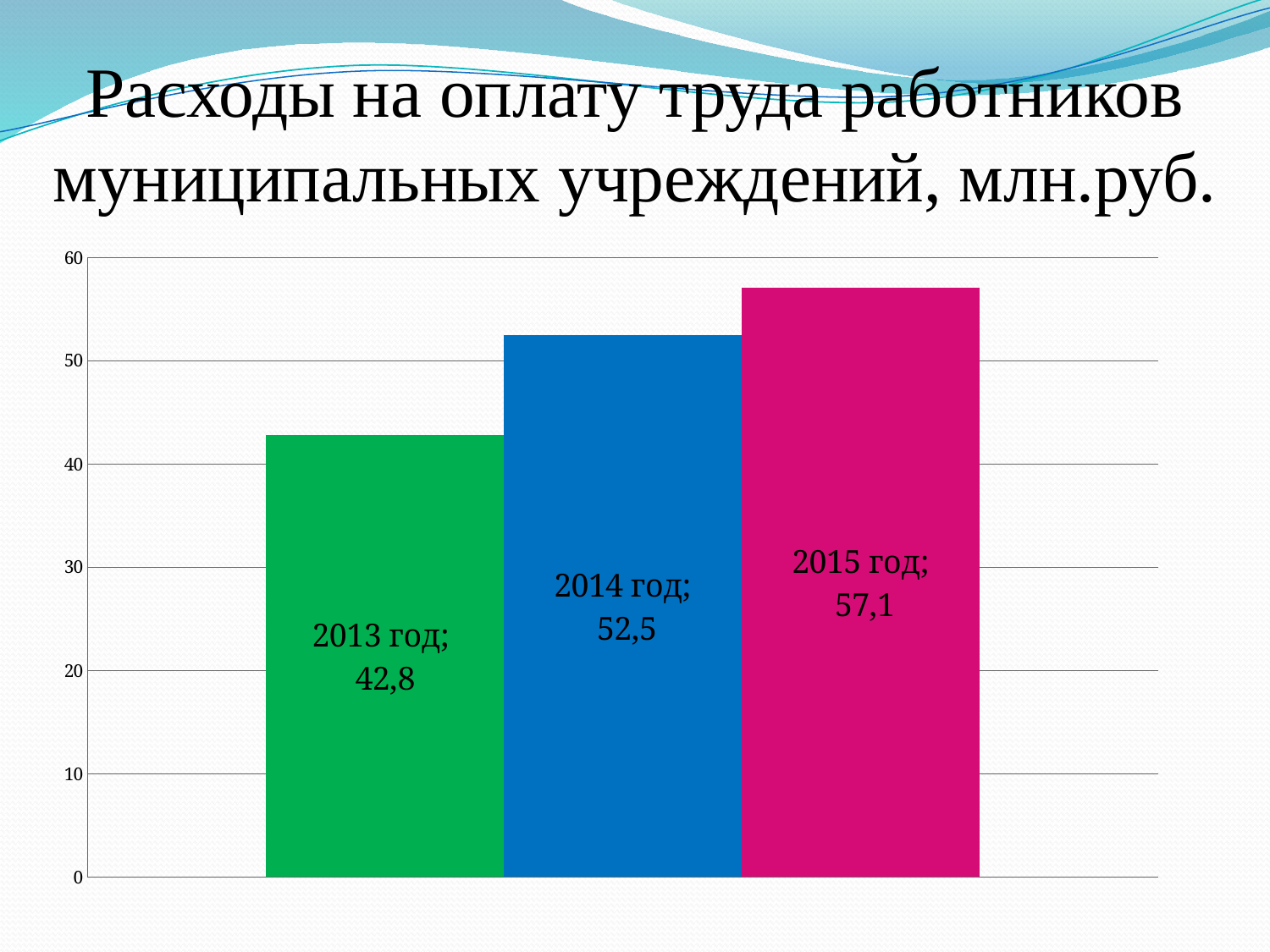
Which is larger, the value for 2014 год or the value for 2013 год? 2014 год What is the value for 2013 год? 42,8 What is the difference between the values for 2014 год and 2013 год? 9,7 Do the values rise or fall from 2013 год to 2015 год? rise What is the value for 2014 год? 52,5 Is the value for 2015 год greater or less than 50? greater What is the value for 2015 год? 57,1 Which year has the highest value? 2015 год Which year has the lowest value? 2013 год What kind of chart is shown on the slide? bar chart What is the difference between the values for 2015 год and 2013 год? 14,3 How many bars are shown in the chart? 3